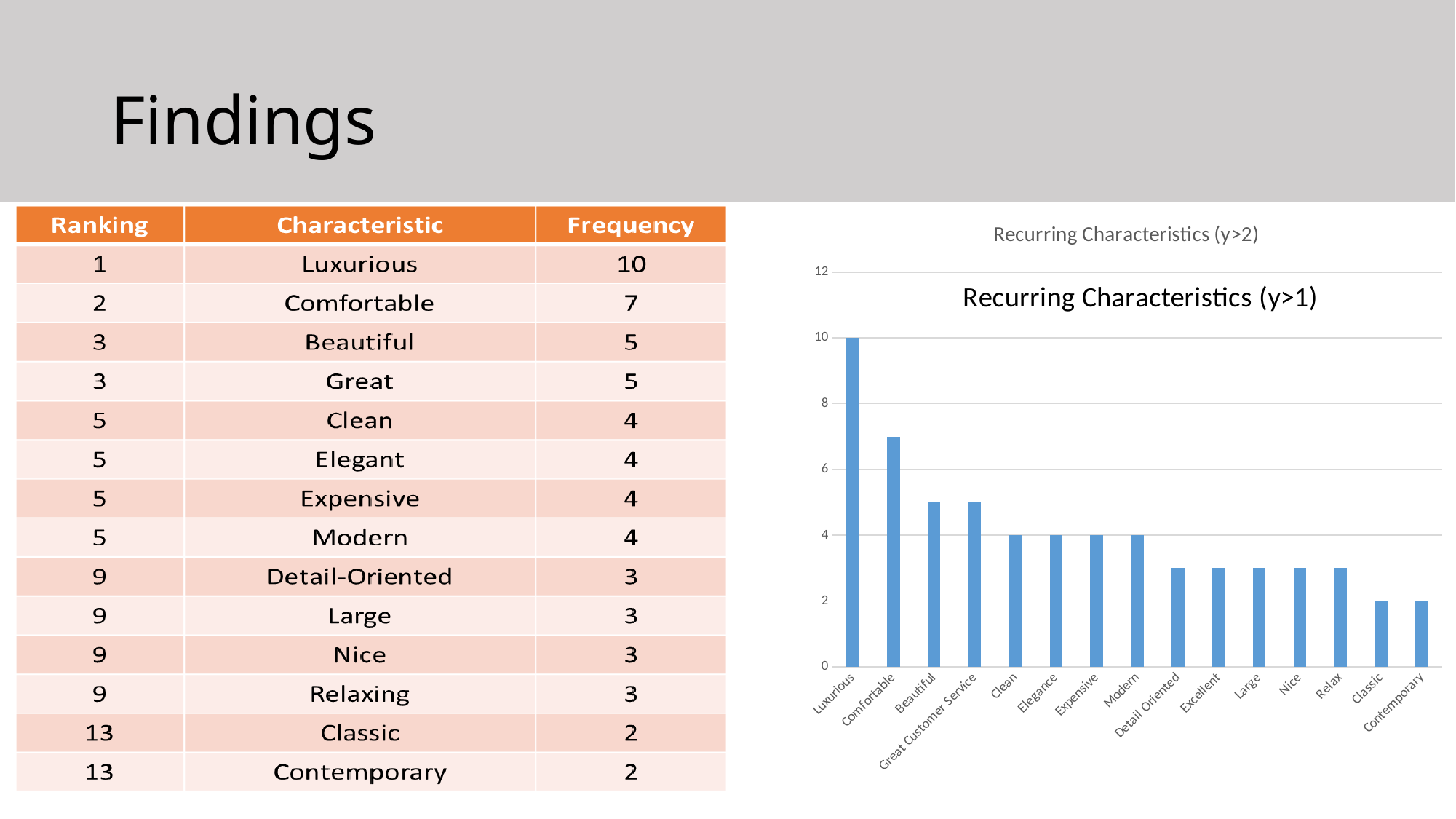
How many categories are shown on the x axis of the chart? 15 Which is larger in the chart, the value for Modern or the value for Nice? Modern Which is larger in the chart, the value for Comfortable or the value for Beautiful? Comfortable What is the value for Clean in the chart? 4 What kind of chart is shown on the slide? bar chart Which category has the highest value in the chart? Luxurious Is the value for Detail Oriented greater or less than 4? less What is the value for Contemporary in the chart? 2 What is the value for Luxurious in the chart? 10 What is the difference between the values for Luxurious and Clean? 6 Is the value for Comfortable greater or less than 6? greater Which two categories share the lowest value in the chart? Classic and Contemporary